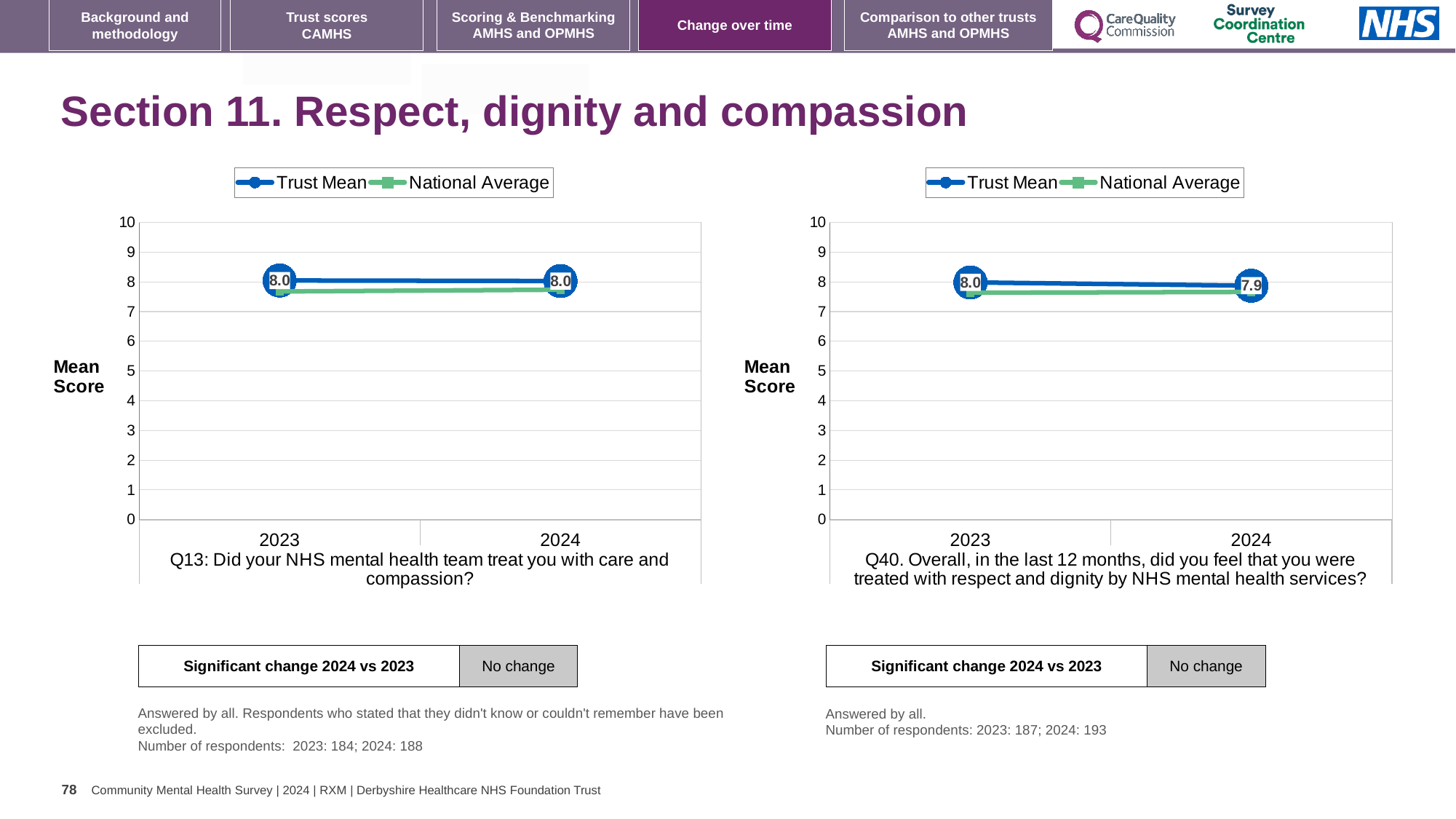
On the right chart (Q40), what is the Trust Mean score for 2024? 7.9 How many series does the legend of the right chart (Q40) list? 2 On the left chart (Q13), what is the Trust Mean score for 2023? 8.0 On the left chart (Q13), is the National Average for 2024 greater or less than 7? greater On the left chart (Q13), does the Trust Mean rise, fall or stay the same from 2023 to 2024? stay the same What kind of chart is used on the left (Q13)? line chart On the left chart (Q13), what is the Trust Mean score for 2024? 8.0 On the right chart (Q40), which is higher in 2023, the Trust Mean or the National Average? Trust Mean On the right chart (Q40), what is the Trust Mean score for 2023? 8.0 On the right chart (Q40), does the Trust Mean rise, fall or stay the same from 2023 to 2024? fall On the right chart (Q40), by how much did the Trust Mean change from 2023 to 2024? 0.1 How many years are shown on the x axis of the left chart (Q13)? 2